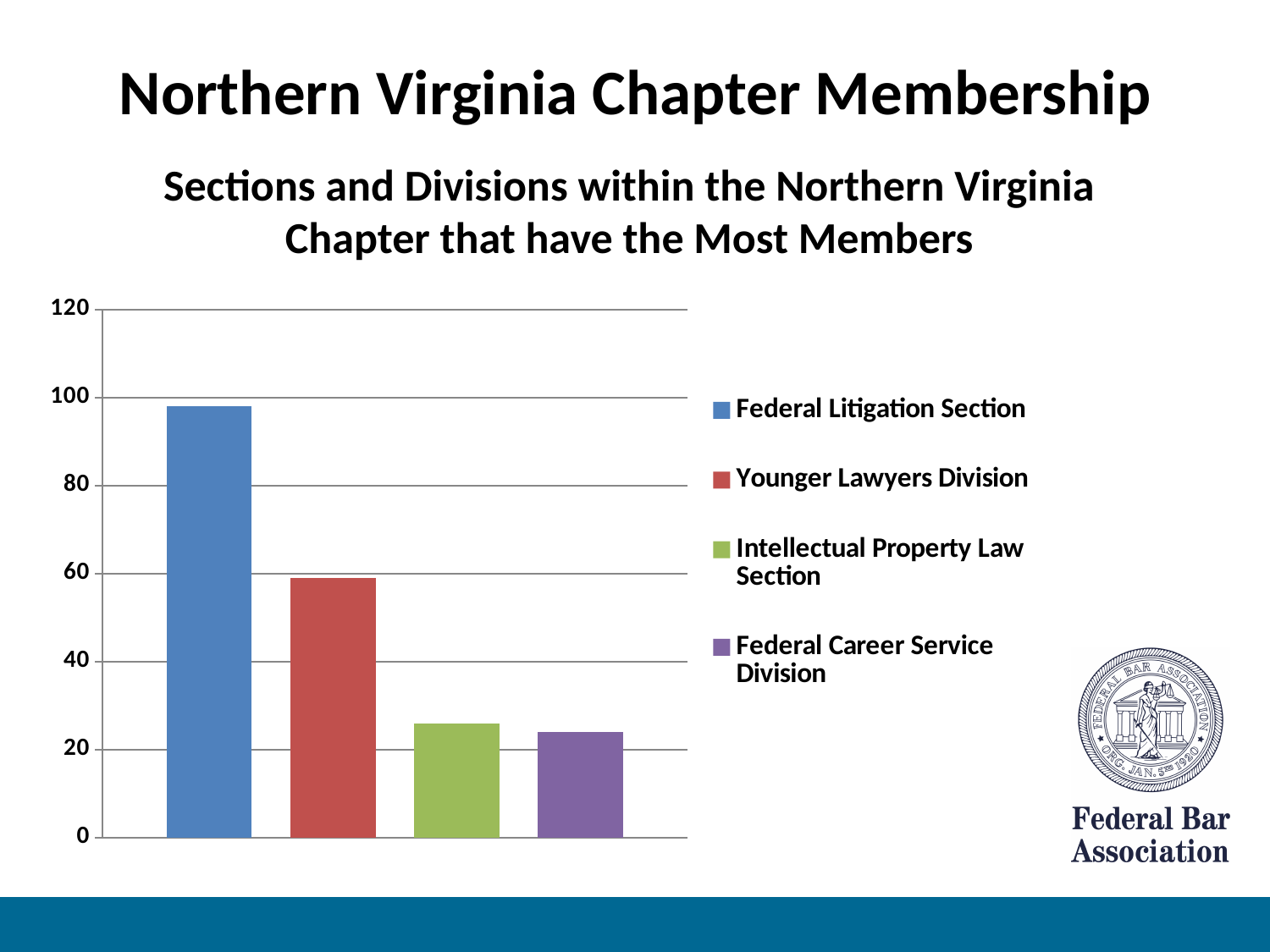
Which has more members, the Younger Lawyers Division or the Intellectual Property Law Section? Younger Lawyers Division How many series does the legend list? 4 Which has more members, the Federal Litigation Section or the Younger Lawyers Division? Federal Litigation Section Is the value for Federal Career Service Division greater or less than 40? less Is the value for Younger Lawyers Division greater or less than 40? greater Is the value for Federal Litigation Section greater or less than 80? greater Which section or division has the most members? Federal Litigation Section What kind of chart is shown on the slide? bar chart How many bars are plotted in the chart? 4 What colour is the bar for the Federal Litigation Section? blue